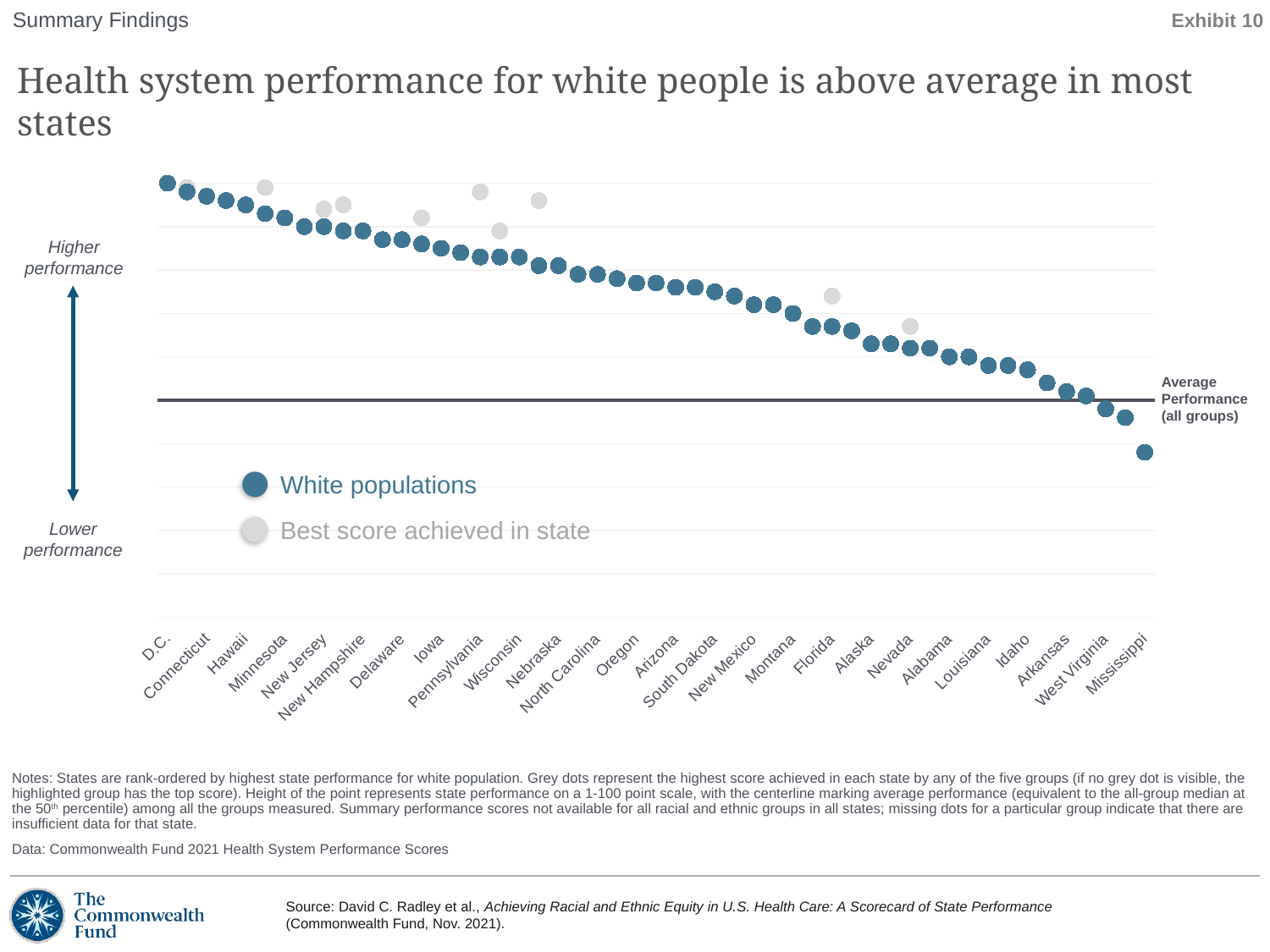
What does the horizontal line across the chart represent? Average Performance (all groups) Which has a higher white population score, Connecticut or Mississippi? Connecticut Do the white population scores rise or fall moving from left to right along the x axis? Fall Which state or jurisdiction has the highest white population performance score? D.C. What are the two series named in the legend? White populations; Best score achieved in state How many series does the legend list? 2 Is D.C.'s white population score above or below the Average Performance (all groups) line? Above Is Mississippi's white population score above or below the Average Performance (all groups) line? Below Which state has the lowest white population performance score? Mississippi What kind of chart is shown on the slide? Dot chart (scatter plot)